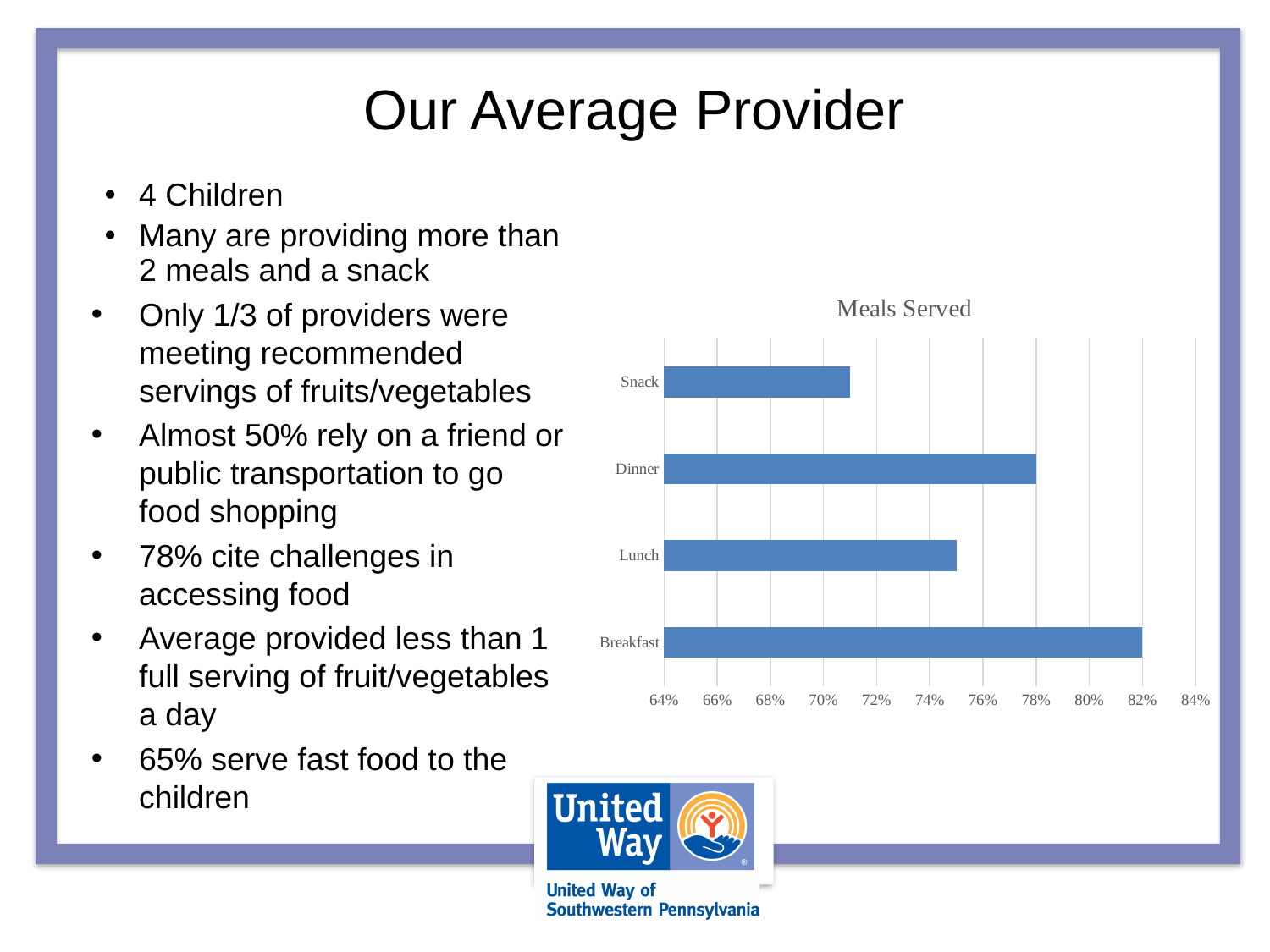
Which meal has the lowest value in the chart? Snack Is the value for Snack greater or less than 70%? greater Is the value for Lunch greater or less than 76%? less What is the value for Dinner? 78% What kind of chart is shown on the slide? Bar chart What is the title of the chart? Meals Served Which is larger, the value for Dinner or the value for Lunch? Dinner Which is larger, the value for Lunch or the value for Snack? Lunch Which meal has the highest value in the chart? Breakfast How many meal categories are plotted in the chart? 4 What is the value for Breakfast? 82% By how many percentage points does Breakfast exceed Dinner? 4 percentage points